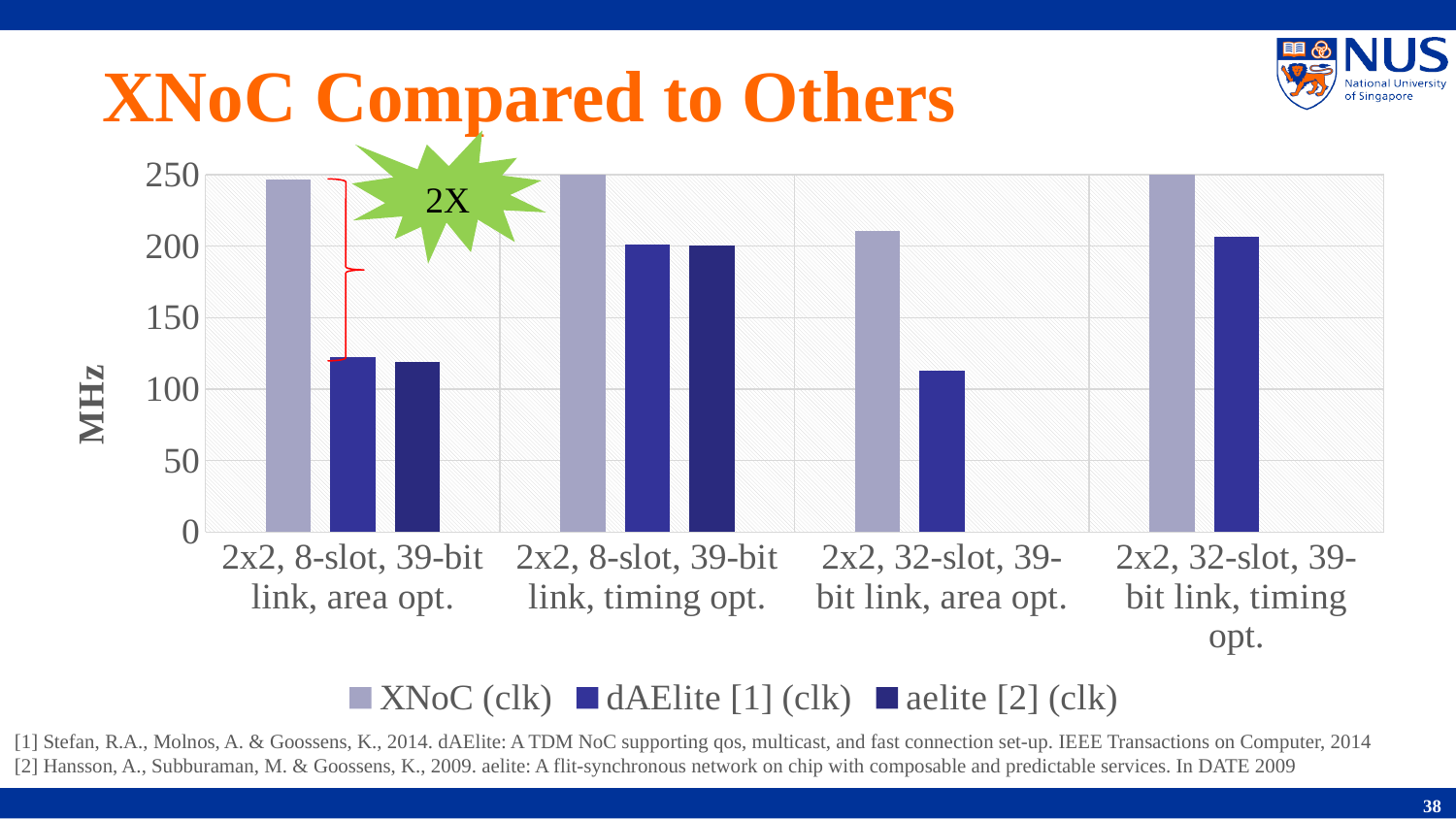
Is the aelite [2] (clk) value for "2x2, 8-slot, 39-bit link, area opt." greater or less than 150? less For "2x2, 32-slot, 39-bit link, timing opt.", which is larger: the XNoC (clk) value or the dAElite [1] (clk) value? XNoC (clk) What kind of chart is shown on the slide? bar chart Is the XNoC (clk) value for "2x2, 8-slot, 39-bit link, area opt." greater or less than 200? greater What is the label on the y axis of the chart? MHz Is the XNoC (clk) value for "2x2, 32-slot, 39-bit link, area opt." greater or less than 200? greater How many series does the chart legend list? 3 Which series is listed first in the chart legend? XNoC (clk) Which series has the highest value for "2x2, 8-slot, 39-bit link, area opt."? XNoC (clk) How many categories are shown on the x axis of the chart? 4